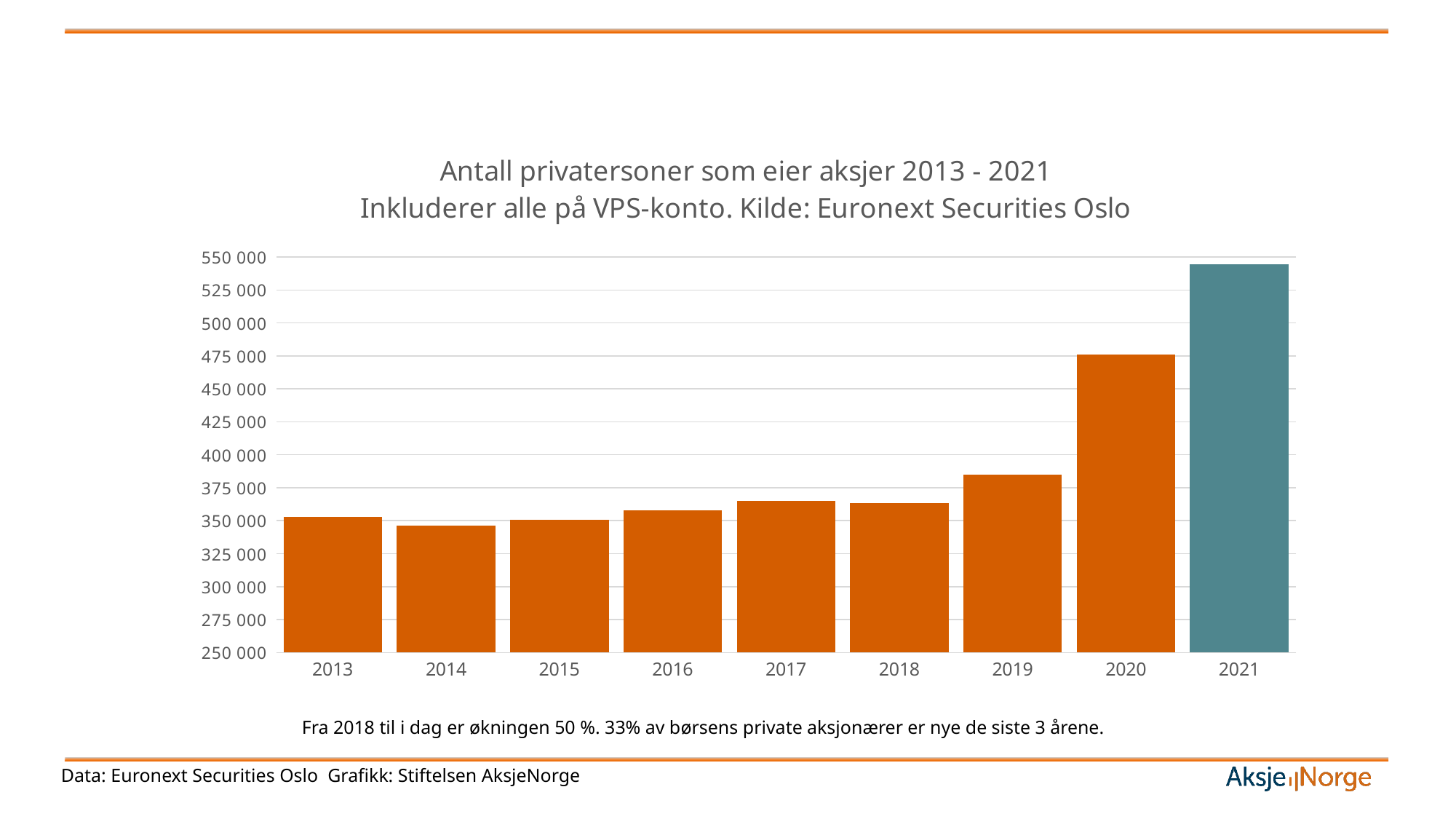
Which year has a higher value, 2016 or 2019? 2019 Which year has the lowest number of private shareholders? 2014 Do the values generally rise or fall from 2018 to 2021? Rise How many years are shown on the x axis of the chart? 9 Which year's bar is shown in a different colour from the others? 2021 Is the value for 2021 greater or less than 525 000? greater Is the value for 2014 greater or less than 350 000? less Is the value for 2017 greater or less than 350 000? greater Which year has the highest number of private shareholders? 2021 What kind of chart is shown on the slide? Bar chart